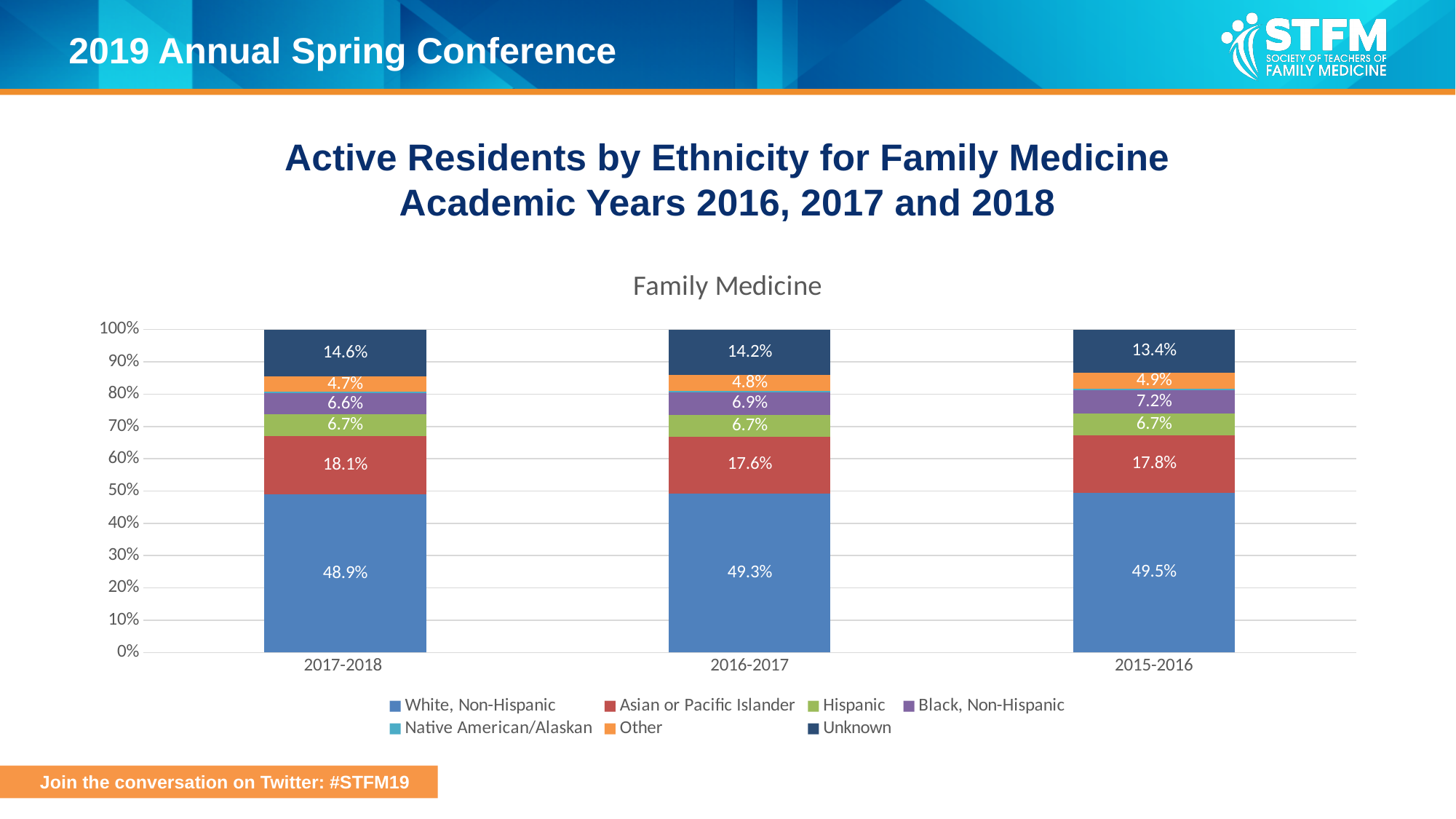
What is the Unknown share for 2015-2016? 13.4% What is the difference between the Asian or Pacific Islander share in 2017-2018 and in 2016-2017? 0.5 percentage points What kind of chart is shown on the slide? Stacked bar chart In which academic year was the Unknown share lowest? 2015-2016 What percentage of residents were Asian or Pacific Islander in 2016-2017? 17.6% How many series does the legend list? 7 In which academic year was the White, Non-Hispanic share highest? 2015-2016 In 2015-2016, which is larger: the Hispanic share or the Black, Non-Hispanic share? Black, Non-Hispanic What percentage of active residents were White, Non-Hispanic in 2017-2018? 48.9% What is the Black, Non-Hispanic share in 2015-2016? 7.2% What is the title printed directly above the chart? Family Medicine How many academic years are shown on the x axis? 3